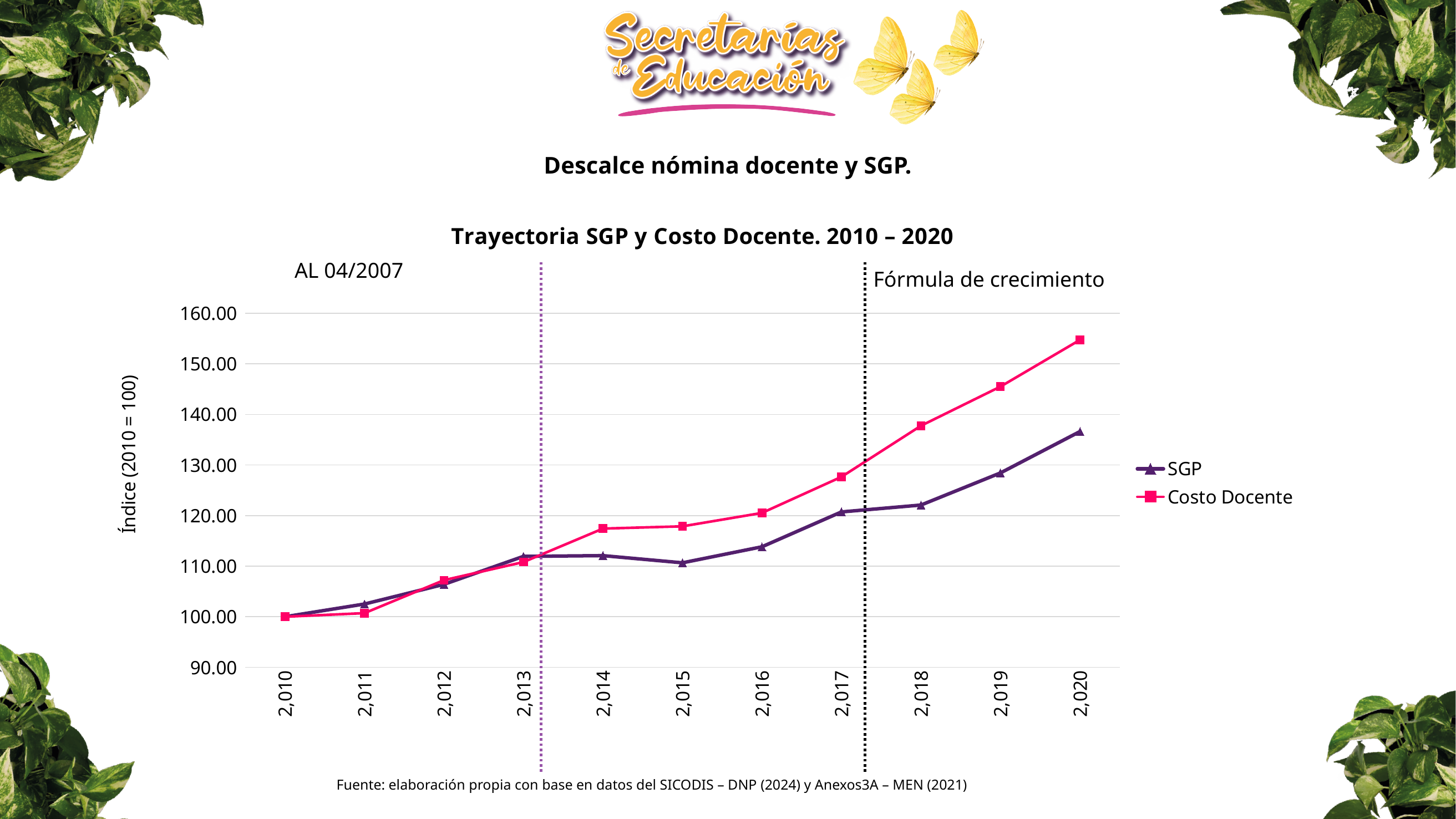
What type of chart is shown on the slide? Line chart How many series does the legend list? 2 Is the value for Costo Docente in 2,017 greater or less than 130.00? less What is the title of the chart? Trayectoria SGP y Costo Docente. 2010 – 2020 Is the value for Costo Docente in 2,020 greater or less than 150.00? greater What is the value of Costo Docente in 2,010? 100.00 Is the value for SGP in 2,020 greater or less than 140.00? less How many years are plotted along the x axis? 11 Do the values of Costo Docente generally rise or fall from 2,010 to 2,020? Rise In which year does Costo Docente reach its highest value? 2,020 What is the value of SGP in 2,010? 100.00 In 2,020, which series has the higher value, SGP or Costo Docente? Costo Docente